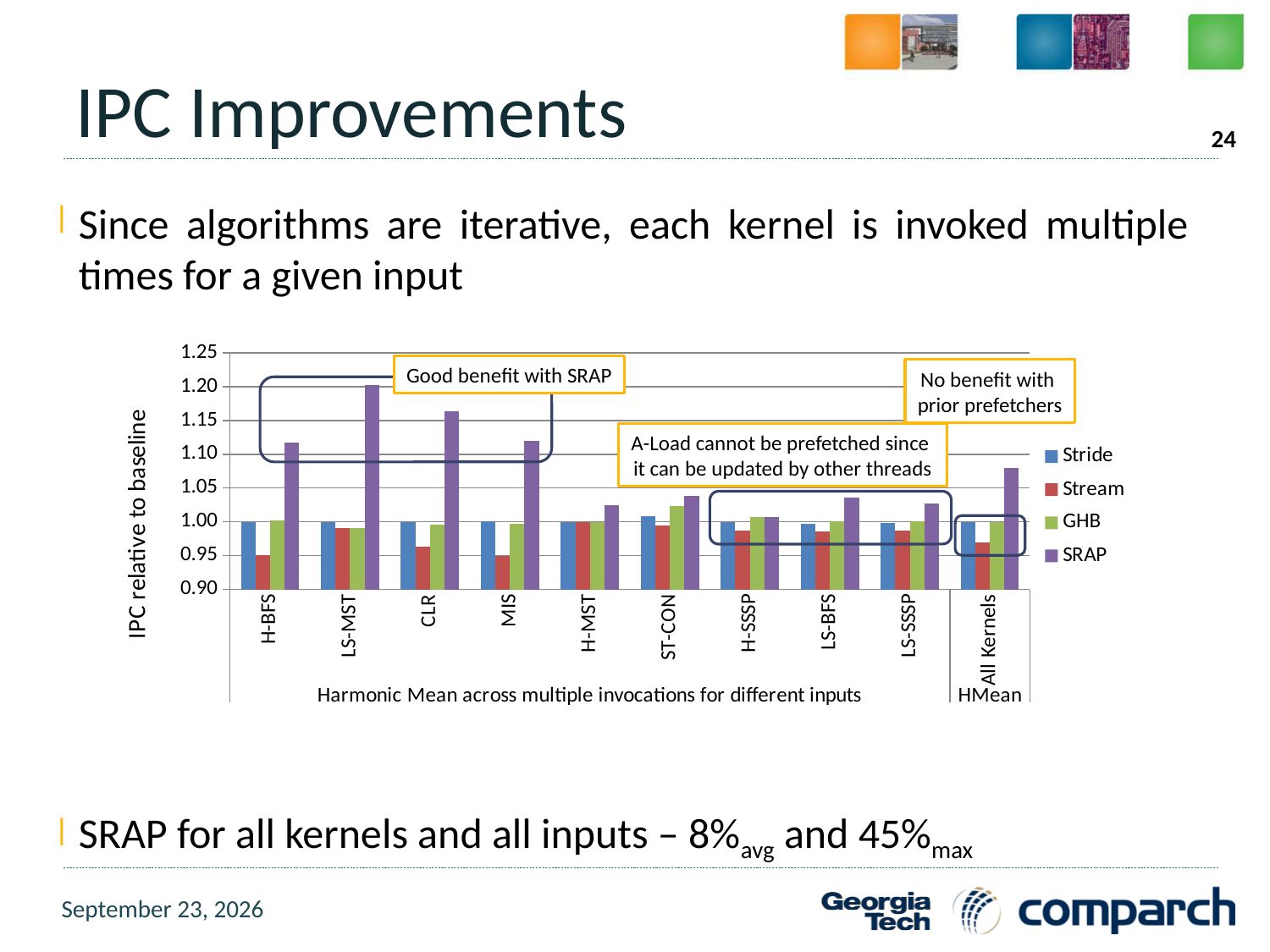
Which series in the chart is shown in purple? SRAP Is the SRAP value for CLR greater or less than 1.15? greater Which kernel has the highest SRAP value in the chart? LS-MST How many series does the chart legend list? 4 Is the Stream value for H-BFS greater or less than 1.00? less Which is larger, the SRAP value for LS-MST or the SRAP value for CLR? LS-MST What is the title of the chart's vertical axis? IPC relative to baseline Is the SRAP value for All Kernels greater or less than 1.05? greater Which is larger for H-BFS, the Stride value or the Stream value? Stride What kind of chart is shown on the slide? bar chart How many kernel categories are shown along the x axis of the chart? 10